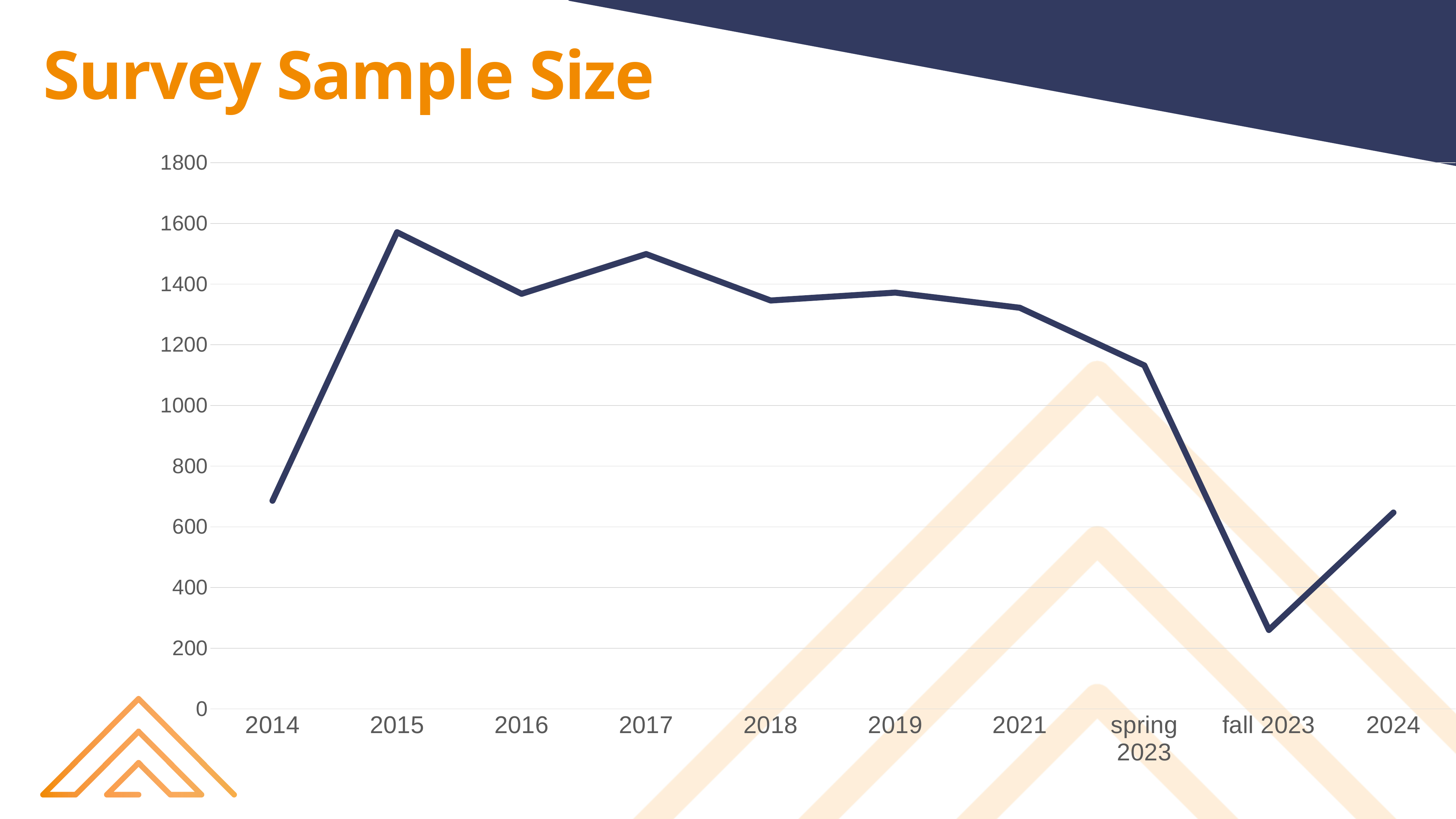
Is the value for 2015 greater or less than 1400? greater Which is larger, the value for spring 2023 or the value for fall 2023? spring 2023 Which category has the lowest survey sample size? fall 2023 Is the value for 2014 greater or less than 800? less Which is larger, the value for 2017 or the value for 2016? 2017 How many points are plotted along the x axis? 10 Do the values rise or fall from 2021 to fall 2023? fall What is the title of the chart? Survey Sample Size Is the value for fall 2023 greater or less than 400? less Which category has the highest survey sample size? 2015 What kind of chart is shown on the slide? line chart